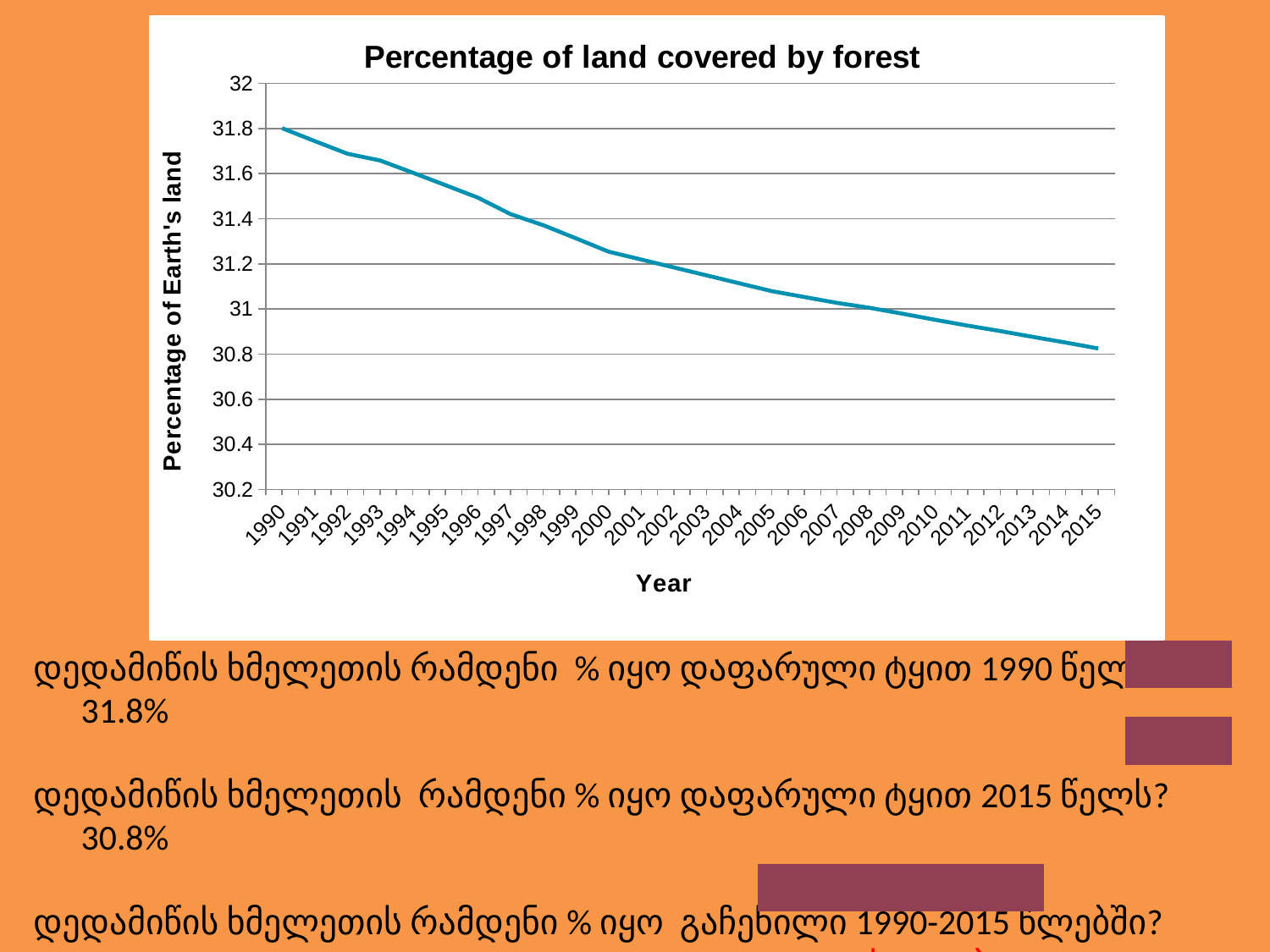
What kind of chart is shown on the slide? line chart Does the percentage of land covered by forest rise or fall from 1990 to 2015? fall Which year has the highest percentage of land covered by forest? 1990 How many years are plotted on the x axis? 26 Is the value for 2015 greater or less than 31? less Is the value for 1995 greater or less than 31.4? greater What is the title of the chart? Percentage of land covered by forest Which year has a higher percentage of land covered by forest, 1995 or 2005? 1995 What is the percentage of land covered by forest in 1990? 31.8 Is the value for 2005 greater or less than 31? greater Which year has the lowest percentage of land covered by forest? 2015 What is the label of the y axis? Percentage of Earth's land